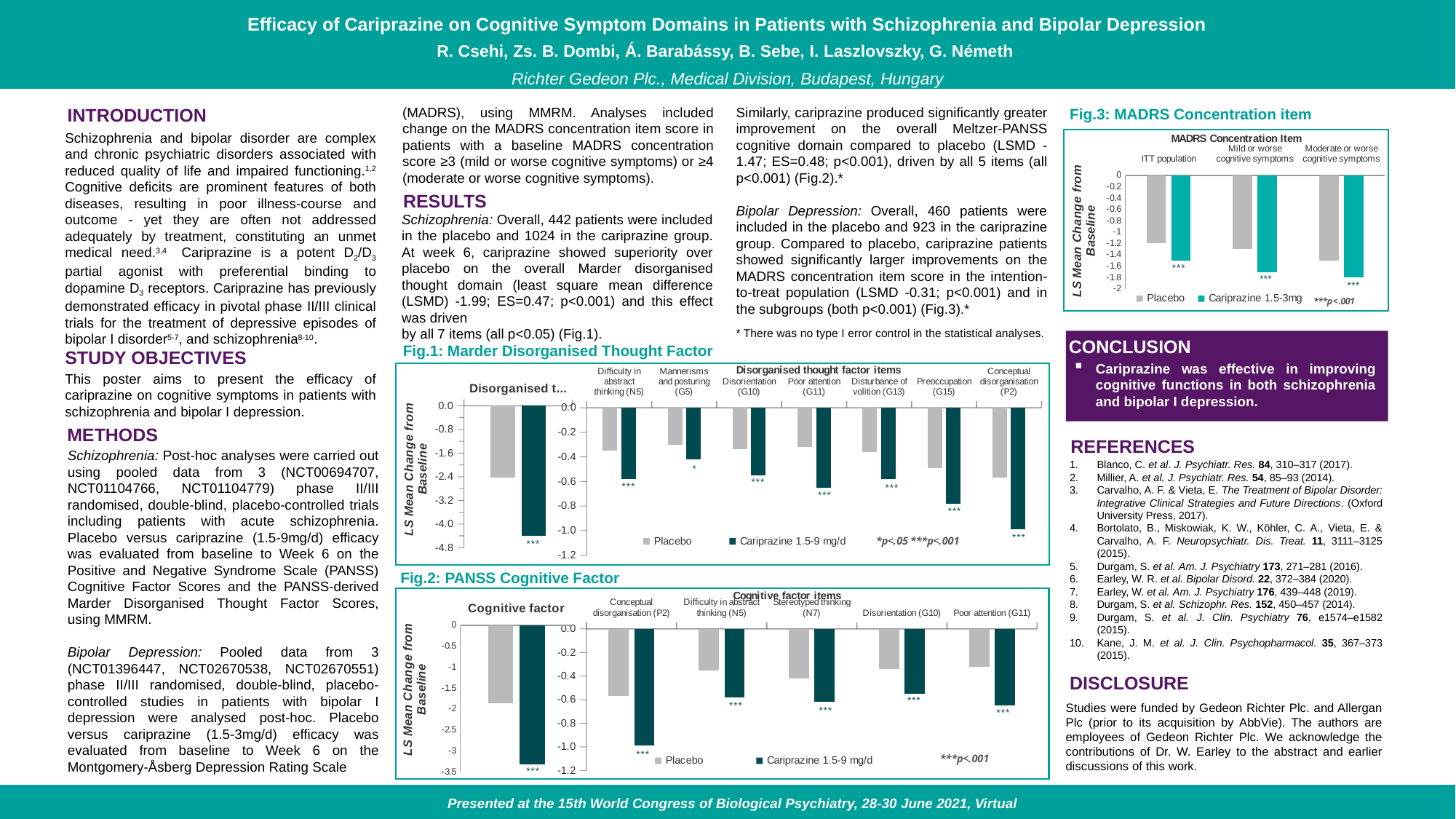
In Fig.3: MADRS Concentration item, is the Placebo value for the ITT population greater or less than -1? less In Fig.1: Marder Disorganised Thought Factor, how many disorganised thought factor items are plotted in the right-hand panel? 7 In Fig.1: Marder Disorganised Thought Factor, is the Cariprazine 1.5-9 mg/d value for the overall disorganised thought factor (left panel) greater or less than -4.0? less In Fig.2: PANSS Cognitive Factor, is the Cariprazine 1.5-9 mg/d value for the overall cognitive factor (left panel) greater or less than -3? less In Fig.3: MADRS Concentration item, which series shows the larger (more negative) change from baseline in the ITT population, Placebo or Cariprazine 1.5-3mg? Cariprazine 1.5-3mg In Fig.2: PANSS Cognitive Factor, how many cognitive factor items are plotted in the right-hand panel? 5 In Fig.1: Marder Disorganised Thought Factor, which series shows the larger (more negative) change for the overall disorganised thought factor, Placebo or Cariprazine 1.5-9 mg/d? Cariprazine 1.5-9 mg/d In Fig.3: MADRS Concentration item, how many population groups are plotted along the x axis? 3 In Fig.2: PANSS Cognitive Factor, what are the two legend entries? Placebo and Cariprazine 1.5-9 mg/d What kind of chart is Fig.3: MADRS Concentration item? Bar chart In Fig.3: MADRS Concentration item, how many series does the legend list? 2 What is the y-axis label of Fig.3: MADRS Concentration item? LS Mean Change from Baseline